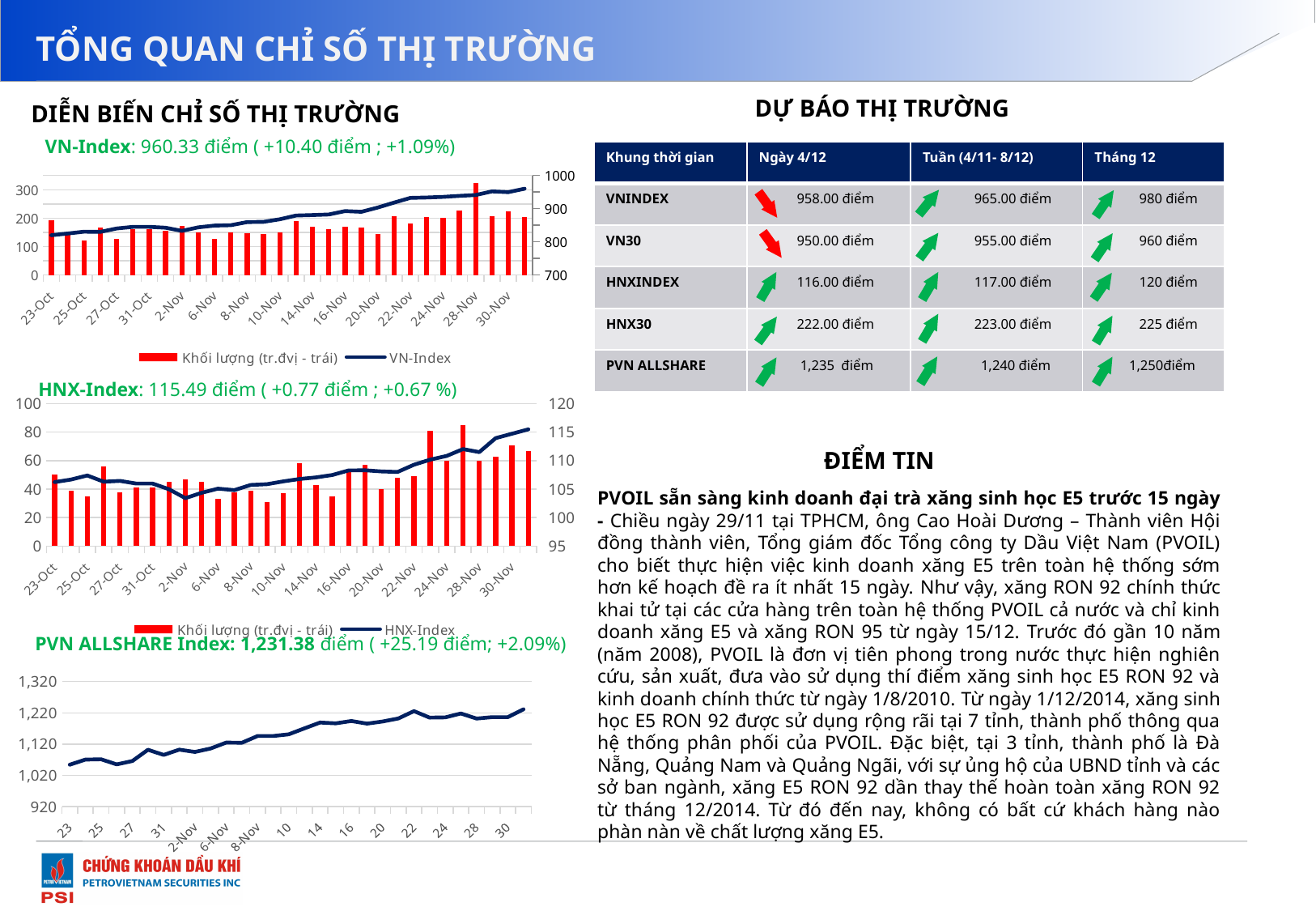
On the PVN ALLSHARE Index chart, does the index generally rise or fall from left to right? rise What kind of chart is the PVN ALLSHARE Index chart? Line chart On the VN-Index chart, is the VN-Index line at 30-Nov greater or less than 900? greater On the VN-Index chart, what are the two legend entries? Khối lượng (tr.đvị - trái) and VN-Index According to the VN-Index chart title, what is the VN-Index value? 960.33 điểm On the VN-Index chart, on which date is the volume bar tallest? 28-Nov On the HNX-Index chart, is the HNX-Index line at 30-Nov greater or less than 110? greater According to the HNX-Index chart title, what is the HNX-Index value? 115.49 điểm According to the PVN ALLSHARE Index chart title, what is the index value? 1,231.38 điểm What kind of chart is the HNX-Index chart? Combined bar and line chart On the VN-Index chart, how many series does the legend list? 2 On the PVN ALLSHARE Index chart, is the value at the first point (23) greater or less than 1,120? less